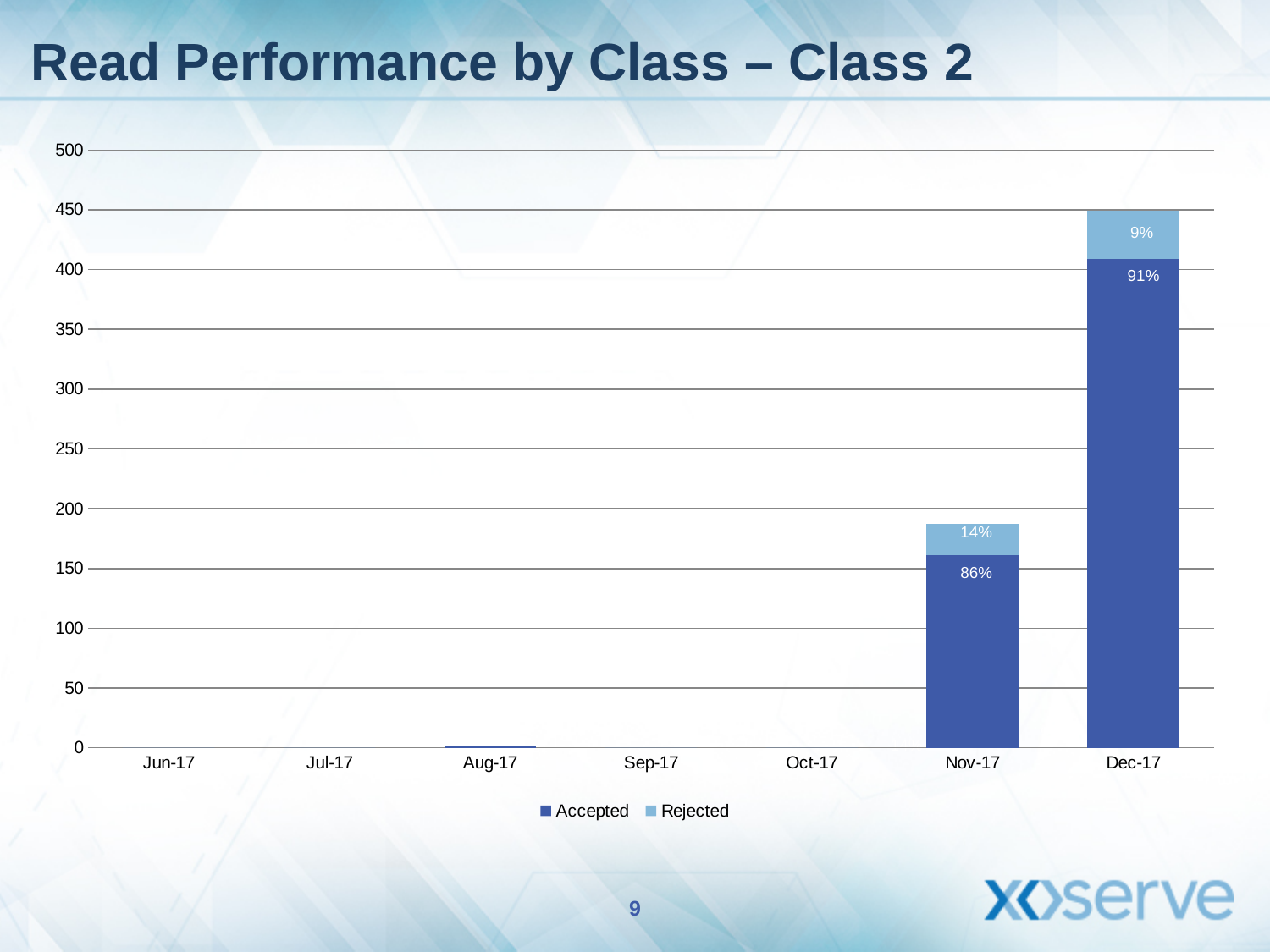
Is the total height of the Dec-17 bar greater or less than 400? greater What percentage label is shown on the Accepted segment for Nov-17? 86% What percentage label is shown on the Rejected segment for Dec-17? 9% What kind of chart is shown on the slide? Stacked bar chart Is the total height of the Nov-17 bar greater or less than 200? less Is the total height of the Nov-17 bar greater or less than 150? greater How many months are shown on the x axis? 7 Which month has the tallest stacked bar? Dec-17 Which bar is taller, Nov-17 or Dec-17? Dec-17 What percentage label is shown on the Accepted segment for Dec-17? 91% What percentage label is shown on the Rejected segment for Nov-17? 14% How many series does the legend list? 2